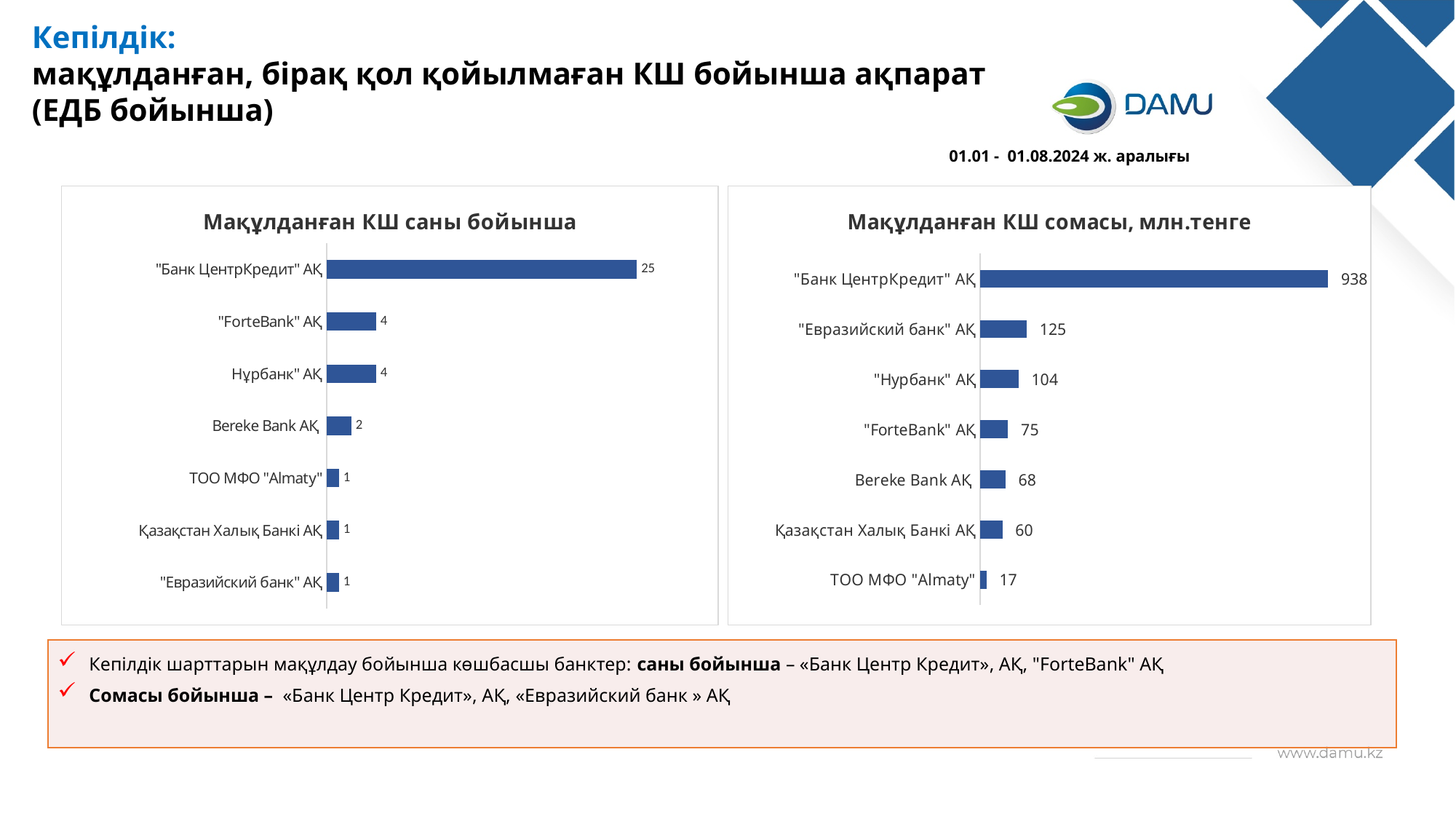
In the left chart "Мақұлданған КШ саны бойынша", which category has the highest value? "Банк ЦентрКредит" АҚ What kind of chart is the right chart "Мақұлданған КШ сомасы, млн.тенге"? Bar chart How many categories are shown in the left chart "Мақұлданған КШ саны бойынша"? 7 In the right chart "Мақұлданған КШ сомасы, млн.тенге", which category has the lowest value? ТОО МФО "Almaty" In the left chart "Мақұлданған КШ саны бойынша", what is the value for Қазақстан Халық Банкі АҚ? 1 In the right chart "Мақұлданған КШ сомасы, млн.тенге", what is the value for "Евразийский банк" АҚ? 125 In the left chart "Мақұлданған КШ саны бойынша", what is the difference between "ForteBank" АҚ and Bereke Bank АҚ? 2 In the right chart "Мақұлданған КШ сомасы, млн.тенге", what is the difference between "Банк ЦентрКредит" АҚ and "Евразийский банк" АҚ? 813 In the left chart "Мақұлданған КШ саны бойынша", what is the value for "Банк ЦентрКредит" АҚ? 25 In the right chart "Мақұлданған КШ сомасы, млн.тенге", what is the value for Bereke Bank АҚ? 68 In the right chart "Мақұлданған КШ сомасы, млн.тенге", which is larger: "Нурбанк" АҚ or "ForteBank" АҚ? "Нурбанк" АҚ What is the title of the chart on the right side of the slide? Мақұлданған КШ сомасы, млн.тенге